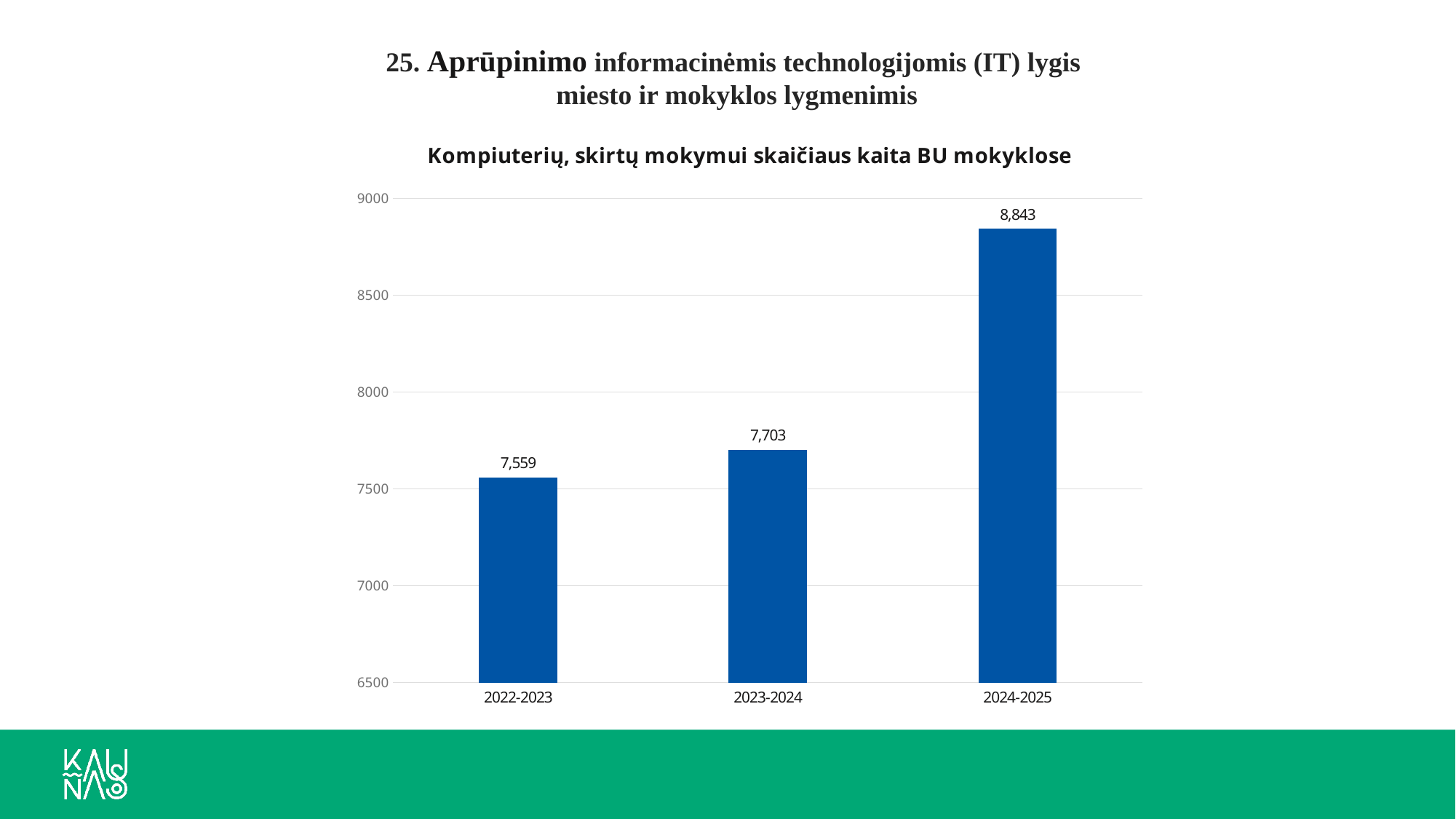
What is the difference between the values for 2024-2025 and 2023-2024? 1,140 How many school years are shown on the chart? 3 Which school year has the lowest value? 2022-2023 Which is larger, the value for 2022-2023 or the value for 2024-2025? 2024-2025 Is the value for 2024-2025 greater or less than 8500? greater What is the value for 2022-2023? 7,559 Which school year has the highest value? 2024-2025 What is the value for 2023-2024? 7,703 What is the difference between the values for 2023-2024 and 2022-2023? 144 What kind of chart is shown on the slide? bar chart Do the values rise or fall from 2022-2023 to 2024-2025? rise What is the value for 2024-2025? 8,843